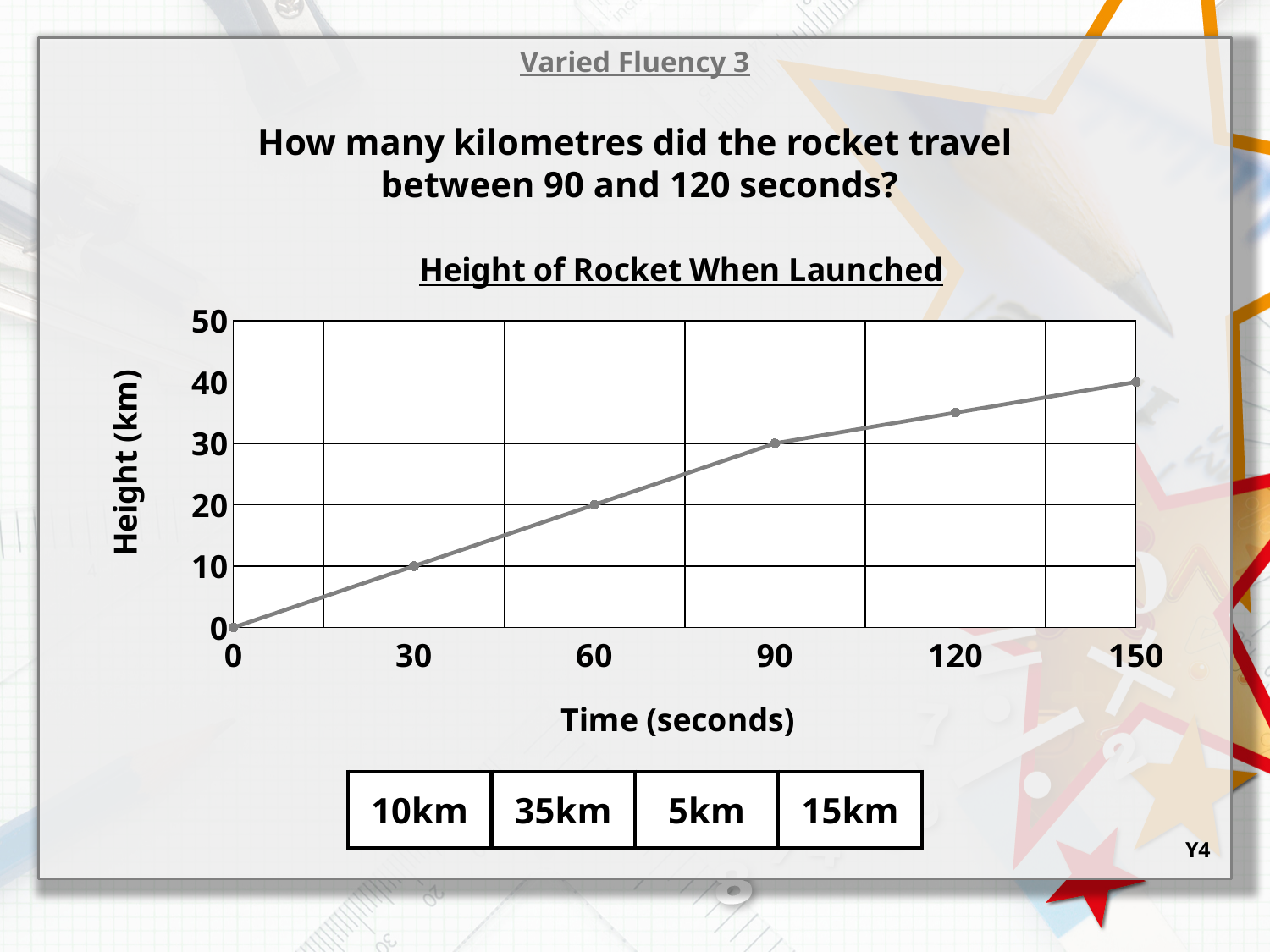
What kind of chart is shown on the slide? line chart Does the height of the rocket rise or fall as time increases? rise At which time is the rocket's height highest? 150 What is the height of the rocket at 150 seconds? 40 What is the height of the rocket at 30 seconds? 10 What is the height of the rocket at 60 seconds? 20 What is the difference in height between 30 seconds and 90 seconds? 20 Is the height of the rocket at 120 seconds greater or less than 30? greater What is the height of the rocket at 90 seconds? 30 What is the title of the chart? Height of Rocket When Launched Is the height of the rocket at 120 seconds greater or less than 40? less How many data points are plotted on the line? 6